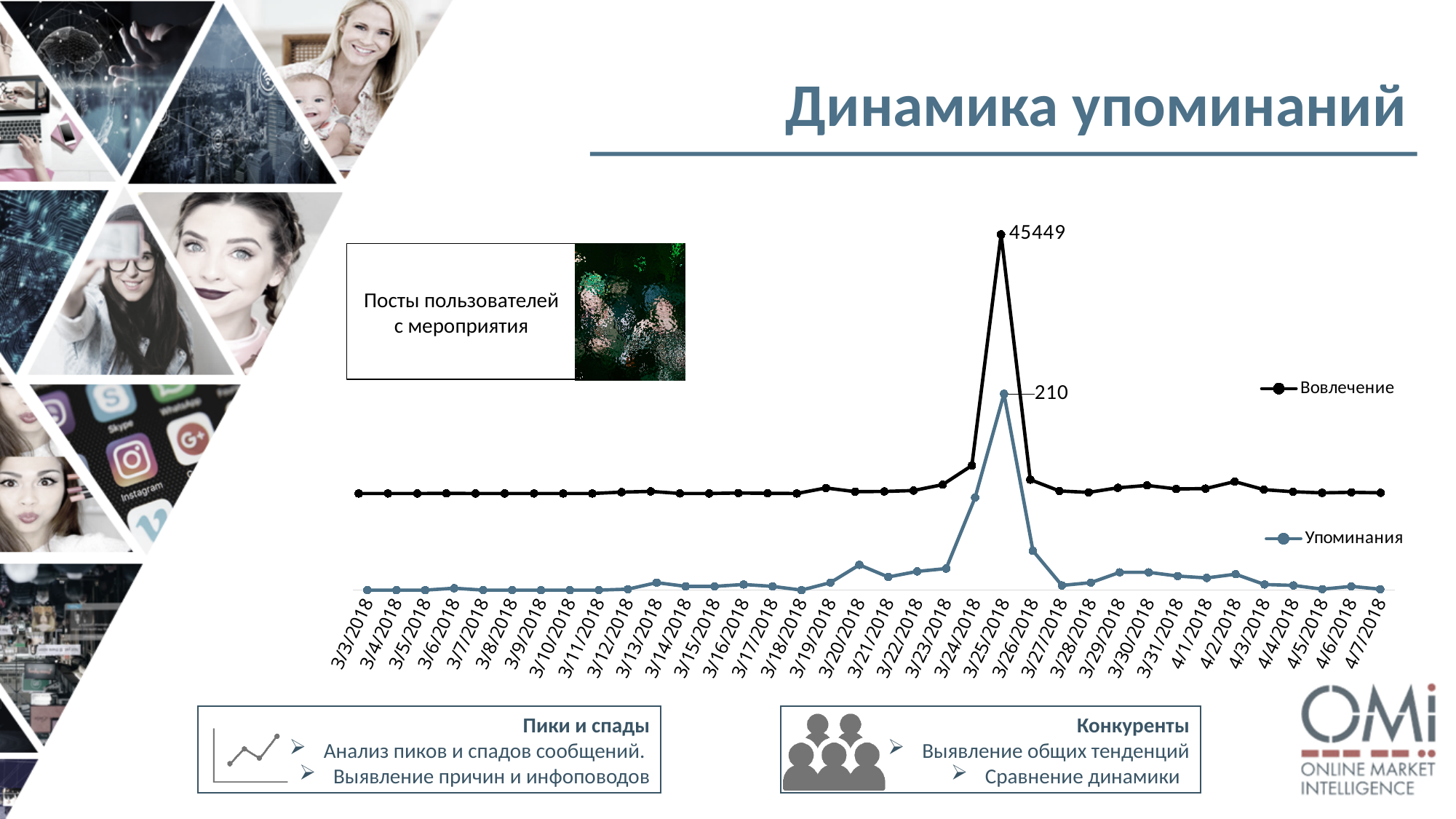
What is the peak value of the Вовлечение series? 45449 What type of chart is shown on the slide? line chart What is the difference between the peak value of Вовлечение and the peak value of Упоминания on 3/25/2018? 45239 What is the peak value of the Упоминания series? 210 On which date does the Вовлечение series reach its highest value? 3/25/2018 How many series does the chart legend list? 2 Which series has the larger value on 3/25/2018, Вовлечение or Упоминания? Вовлечение On which date does the Упоминания series reach its highest value? 3/25/2018 What are the two series named in the chart legend? Вовлечение and Упоминания How many dates are shown on the x axis of the chart? 36 What is the title of the slide containing the chart? Динамика упоминаний What is the first date shown on the x axis of the chart? 3/3/2018